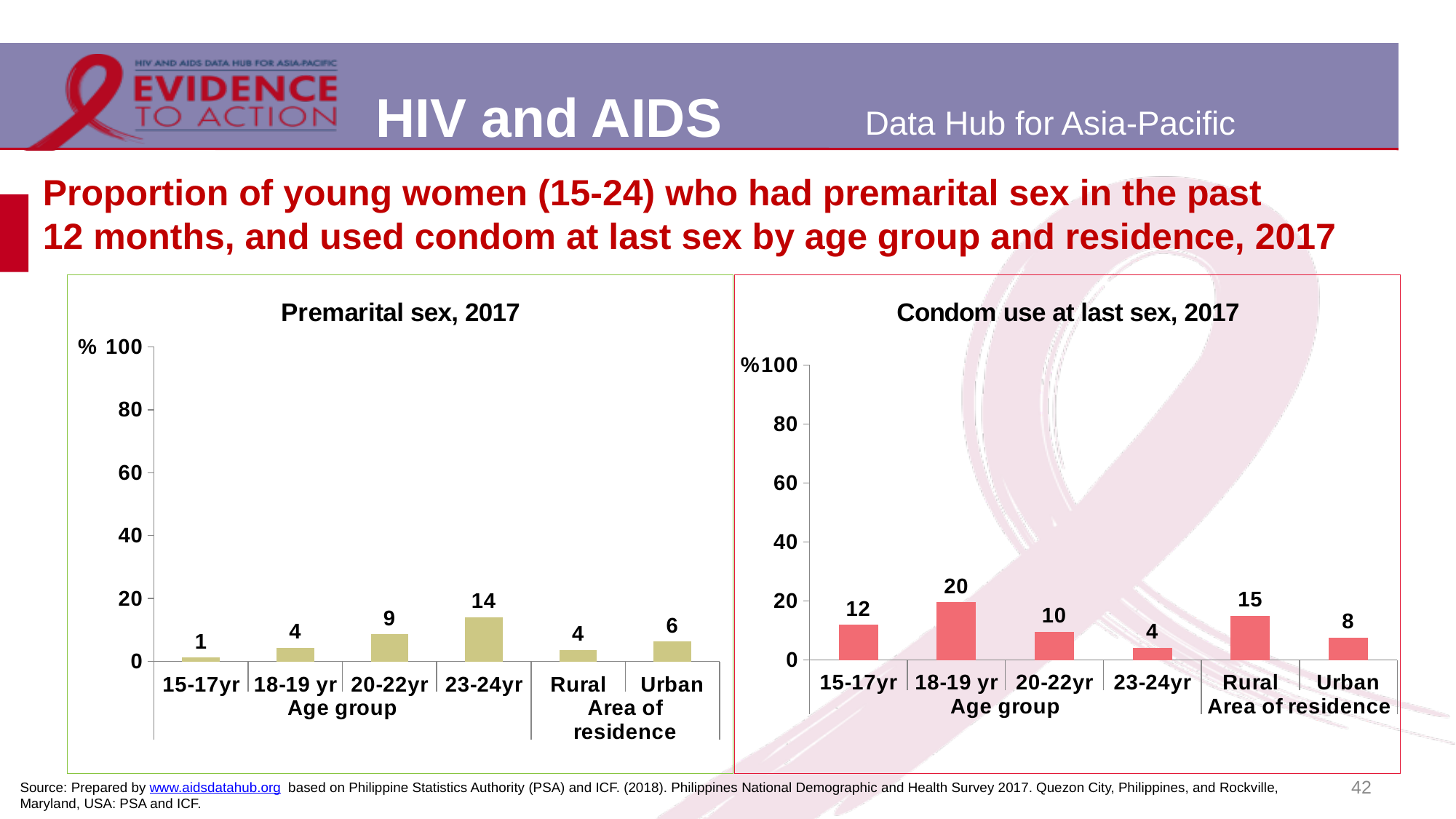
In the 'Condom use at last sex, 2017' chart, what is the difference between the Rural and Urban values? 7 In the 'Premarital sex, 2017' chart, what is the difference between the Urban and Rural values? 2 In the 'Premarital sex, 2017' chart, which category has the lowest value? 15-17yr In the 'Premarital sex, 2017' chart, what is the value for the 23-24yr age group? 14 In the 'Condom use at last sex, 2017' chart, which is larger: the value for 15-17yr or the value for 20-22yr? 15-17yr In the 'Condom use at last sex, 2017' chart, which category has the highest value? 18-19 yr In the 'Condom use at last sex, 2017' chart, what is the value for the 18-19 yr age group? 20 In the 'Premarital sex, 2017' chart, what is the value for Rural? 4 What kind of chart is the 'Condom use at last sex, 2017' chart? bar chart In the 'Premarital sex, 2017' chart, do the values rise or fall across the age groups from 15-17yr to 23-24yr? rise In the 'Premarital sex, 2017' chart, is the value for 23-24yr greater or less than 20? less How many categories are plotted in the 'Premarital sex, 2017' chart? 6